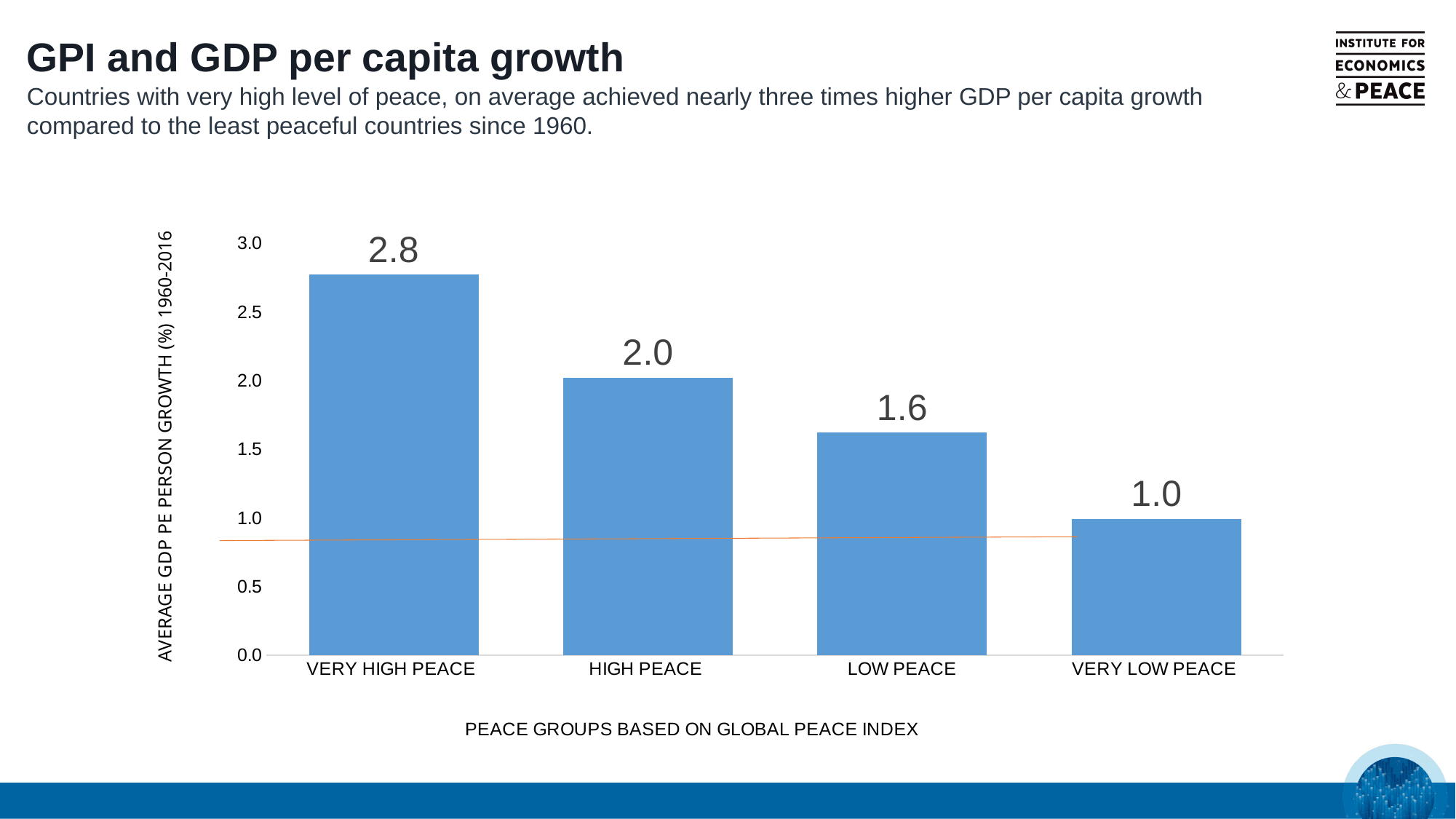
What is the label of the x axis? Peace groups based on Global Peace Index What is the average GDP per person growth for the Very Low Peace group? 1.0 What is the average GDP per person growth for the Low Peace group? 1.6 What is the difference in average GDP per person growth between the Very High Peace and Very Low Peace groups? 1.8 Which has a higher average GDP per person growth, High Peace or Low Peace? High Peace What is the average GDP per person growth for the High Peace group? 2.0 Which peace group has the highest average GDP per person growth? Very High Peace Do the values rise or fall moving from Very High Peace to Very Low Peace along the x axis? Fall What is the average GDP per person growth for the Very High Peace group? 2.8 What kind of chart is shown on the slide? Bar chart Which peace group has the lowest average GDP per person growth? Very Low Peace How many peace groups are shown on the x axis? 4